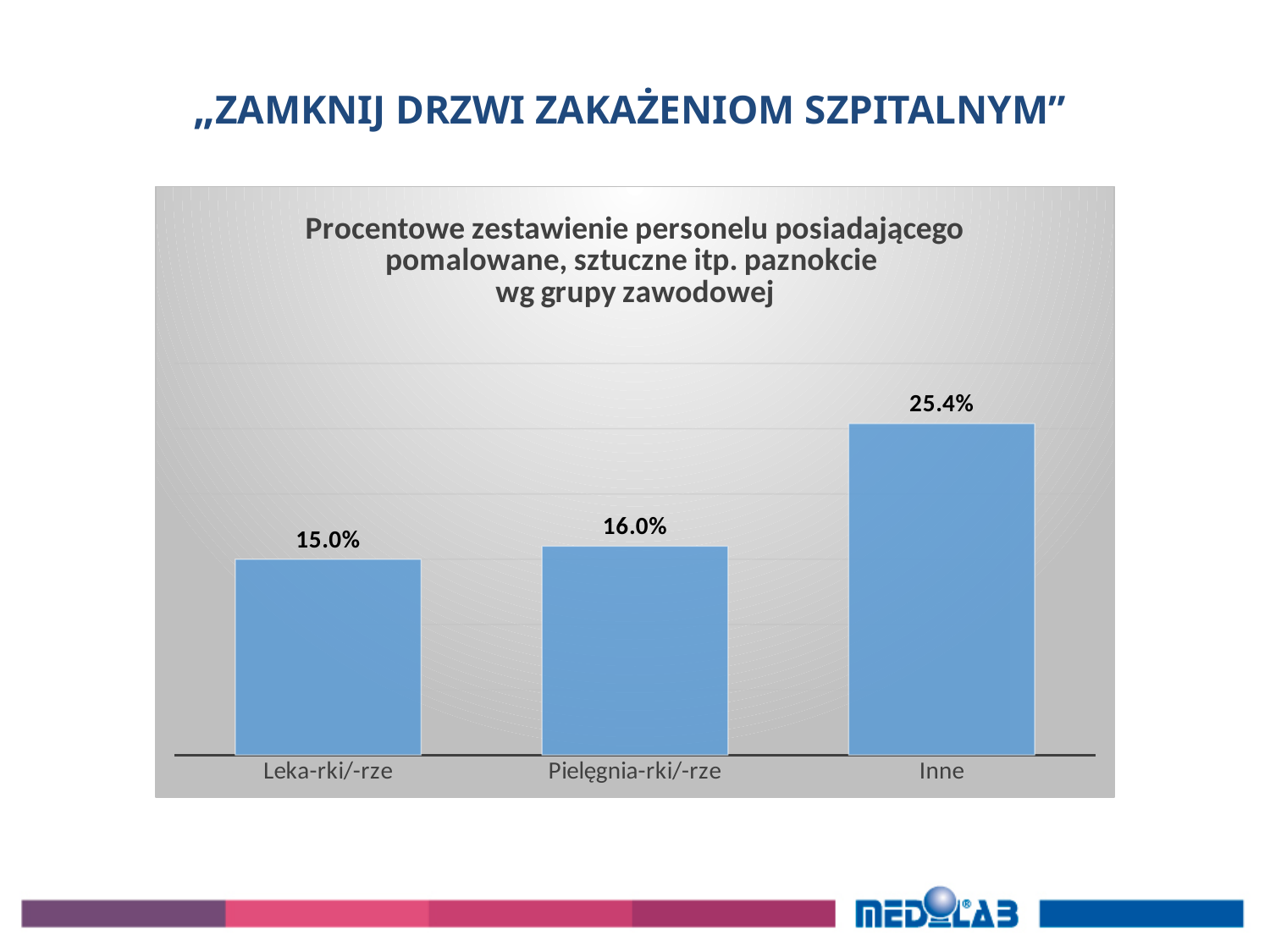
How many categories are shown on the x axis? 3 What is the value for Pielęgnia-rki/-rze? 16.0% What is the value for Inne? 25.4% What is the difference between the values for Inne and Leka-rki/-rze? 10.4% What is the value for Leka-rki/-rze? 15.0% Which category has the lowest value? Leka-rki/-rze Which category has the highest value? Inne What kind of chart is shown on the slide? Bar chart Do the values rise or fall from left to right along the x axis? Rise Which is larger, the value for Inne or the value for Pielęgnia-rki/-rze? Inne What is the difference between the values for Pielęgnia-rki/-rze and Leka-rki/-rze? 1.0% What is the title of the chart? Procentowe zestawienie personelu posiadającego pomalowane, sztuczne itp. paznokcie wg grupy zawodowej